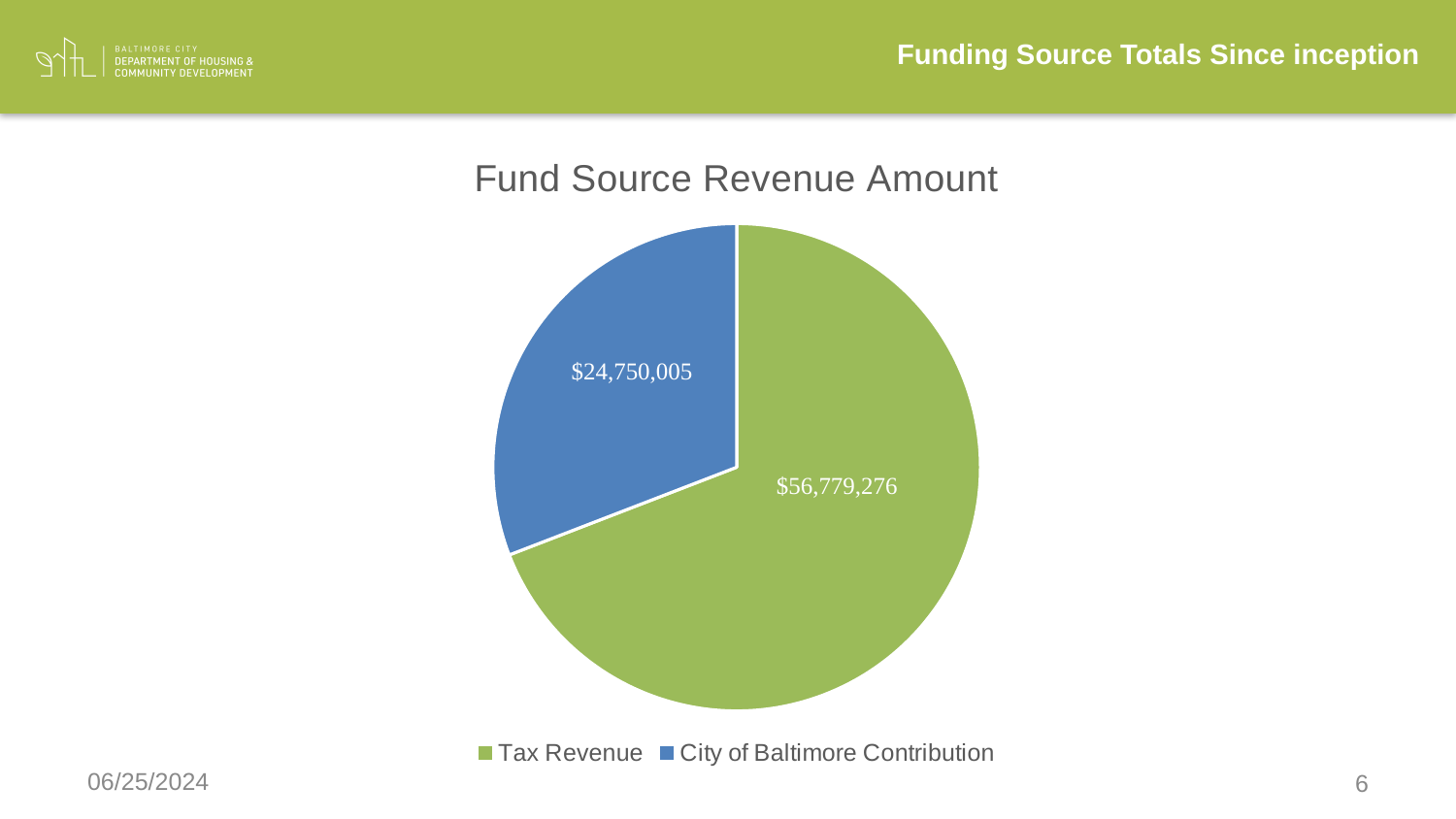
What is the title of the chart? Fund Source Revenue Amount What is the value for Tax Revenue? $56,779,276 Which fund source has the largest slice of the pie? Tax Revenue What is the value for City of Baltimore Contribution? $24,750,005 What type of chart is shown on the slide? Pie chart Which fund source has the smallest slice of the pie? City of Baltimore Contribution Which colour represents City of Baltimore Contribution in the legend? Blue What is the difference between Tax Revenue and City of Baltimore Contribution? $32,029,271 How many slices does the pie chart have? 2 Which is larger, Tax Revenue or City of Baltimore Contribution? Tax Revenue What is the total of the two slices in the pie chart? $81,529,281